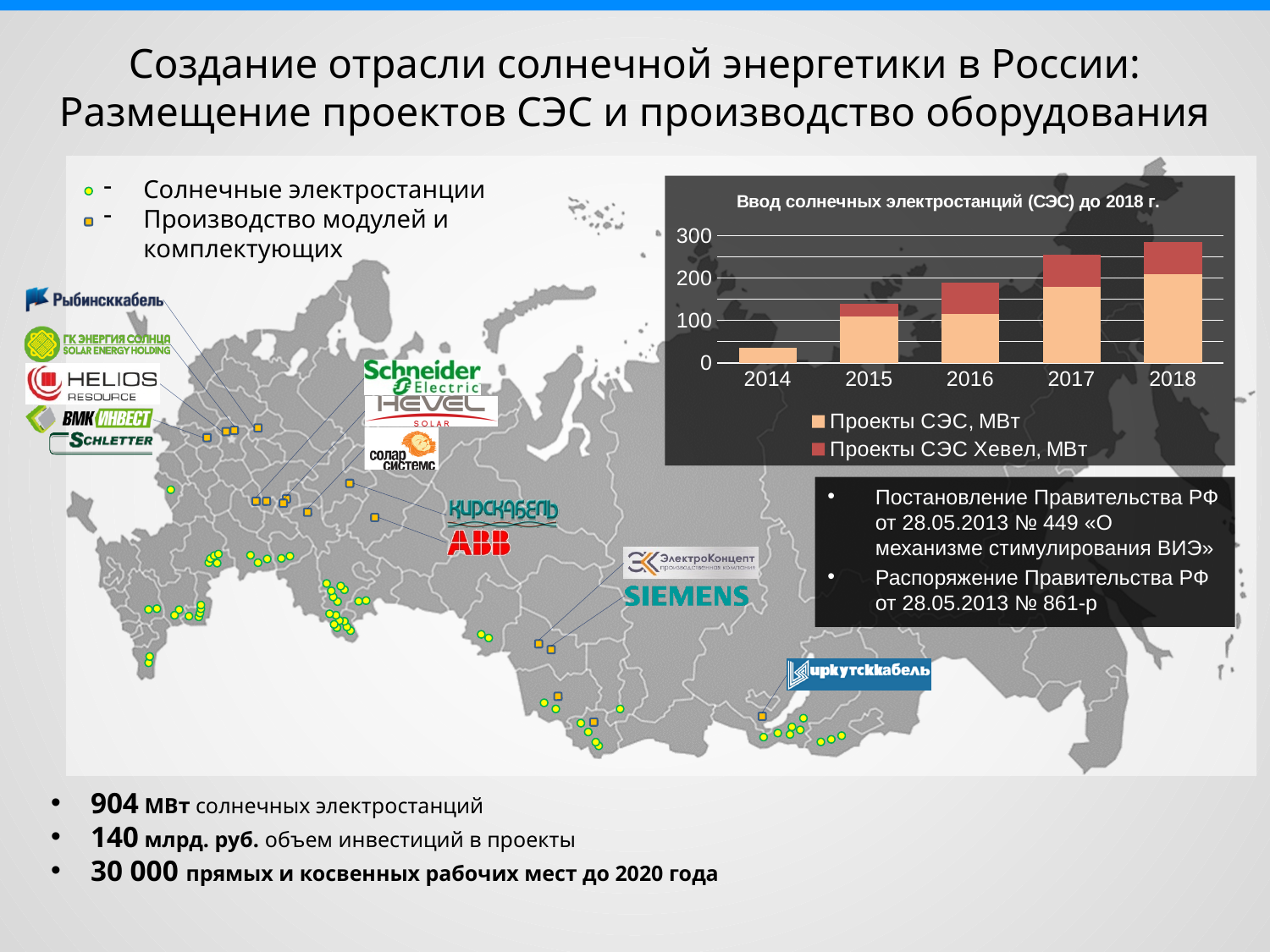
Is the total stacked value for 2014 greater or less than 100? less Which year has the tallest stacked bar in the chart? 2018 Which legend entry is shown in the darker red colour? Проекты СЭС Хевел, МВт What kind of chart is shown on the slide? bar chart Is the total stacked value for 2017 greater or less than 200? greater Do the total bar heights rise or fall from 2014 to 2018? rise How many years are shown on the x axis of the chart? 5 What is the title of the chart? Ввод солнечных электростанций (СЭС) до 2018 г. Which is larger: the total stacked bar for 2016 or for 2015? 2016 Which year has the shortest stacked bar in the chart? 2014 How many series does the chart legend list? 2